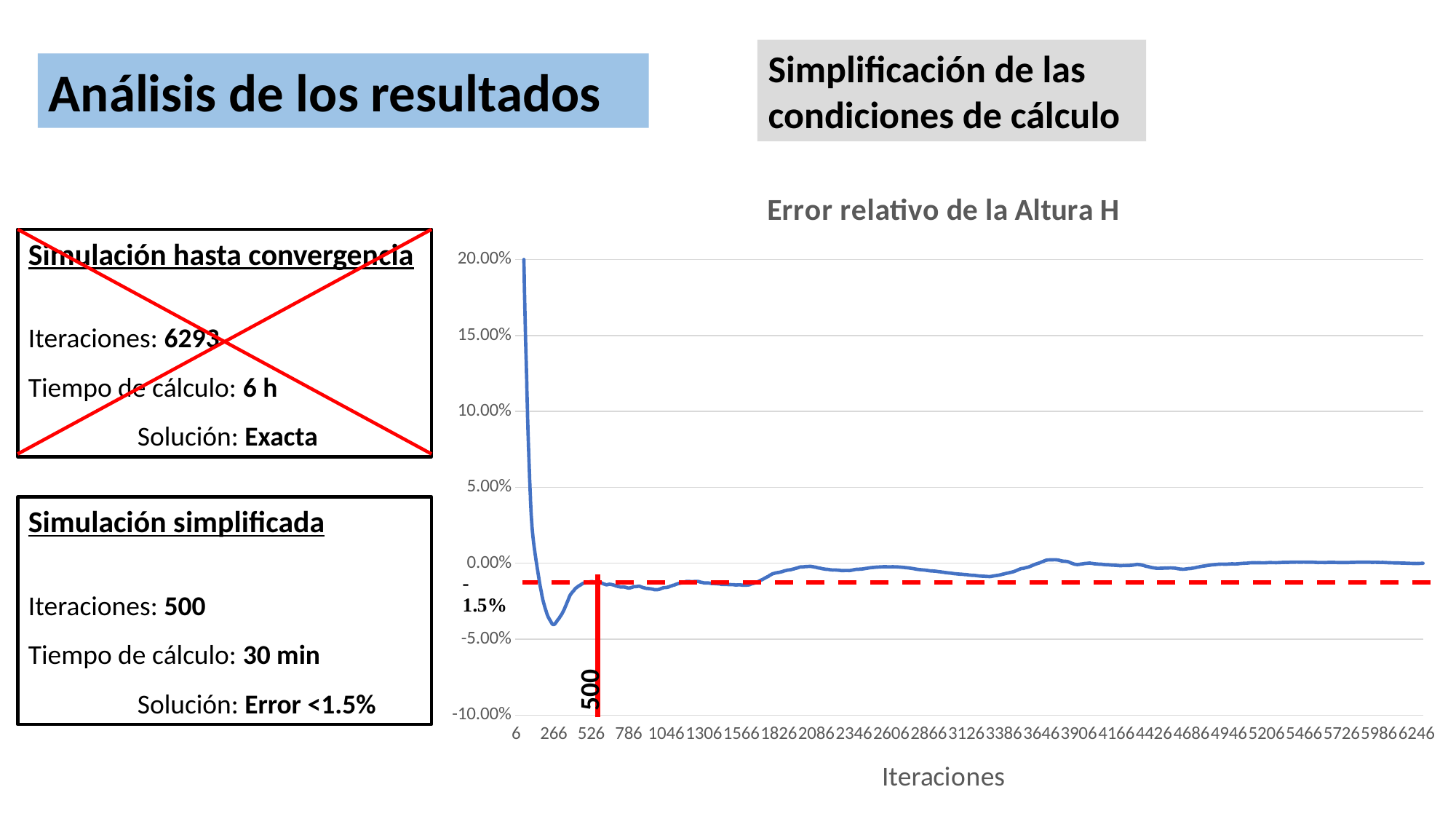
What is the highest value shown on the y axis of the chart? 20.00% Does the relative error rise or fall along the x axis at the start of the chart (from iteration 6 to about 266)? fall Is the relative error at the first iteration (6) greater or less than 15.00%? greater Is the lowest value of the relative error line greater or less than -5.00%? greater What error level does the red dashed horizontal line mark on the chart? -1.5% Is the lowest value of the relative error line greater or less than 0.00%? less What kind of chart is shown on the slide? line chart What is the label of the x axis of the chart? Iteraciones What is the lowest value shown on the y axis of the chart? -10.00% What is the title of the chart? Error relativo de la Altura H At which iteration is the red vertical line drawn on the chart? 500